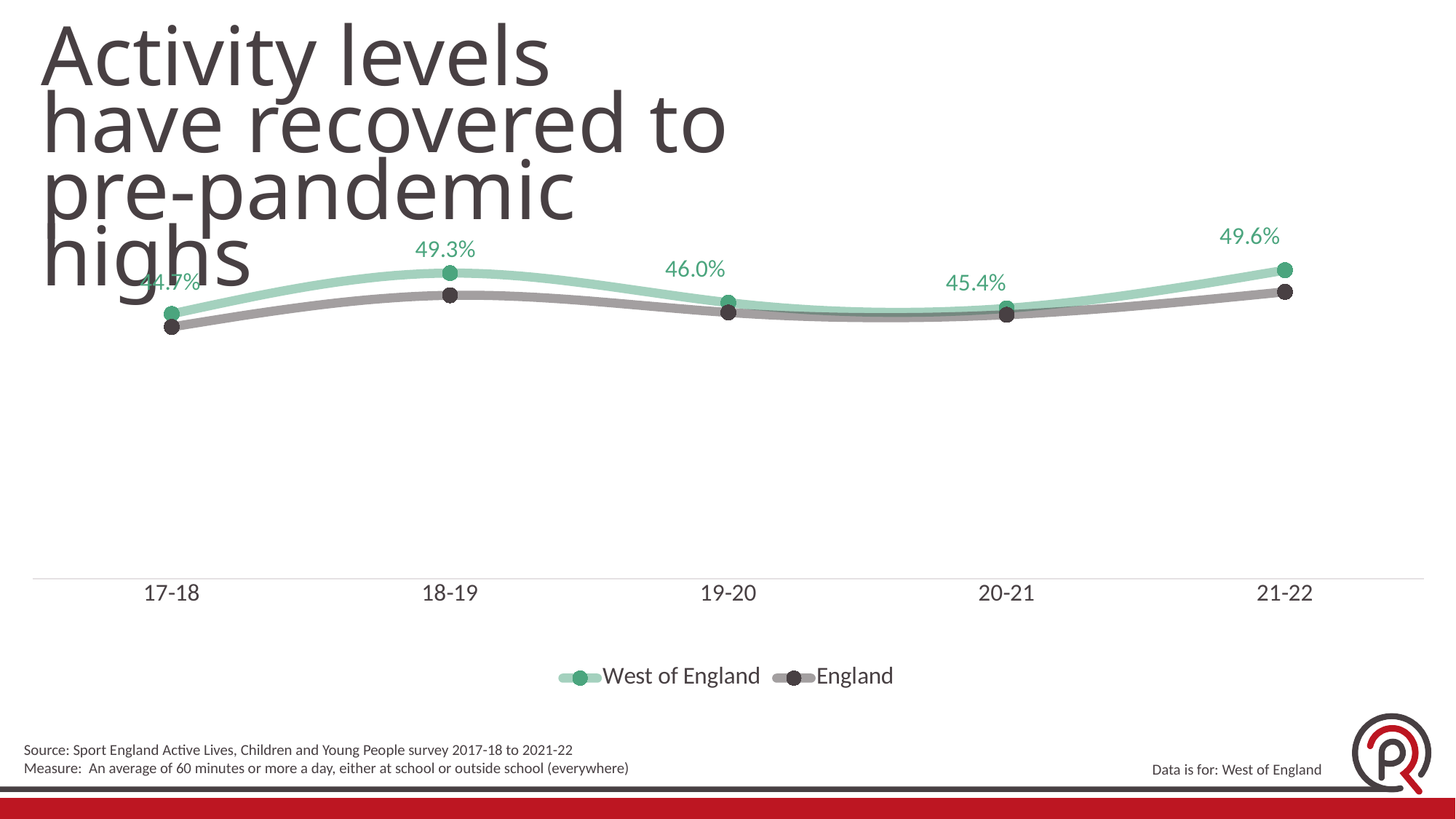
What is the difference between the West of England values for 21-22 and 17-18? 4.9 percentage points How many series does the legend list? 2 What is the West of England value for 20-21? 45.4% In which year is the West of England value lowest? 17-18 Does the West of England value rise or fall from 18-19 to 20-21? Fall How many years are plotted on the x axis? 5 What is the West of England value for 19-20? 46.0% What kind of chart is shown on the slide? Line chart What is the West of England value for 21-22? 49.6% In 18-19, which series has the higher value, West of England or England? West of England What is the West of England value for 18-19? 49.3% In which year is the West of England value highest? 21-22